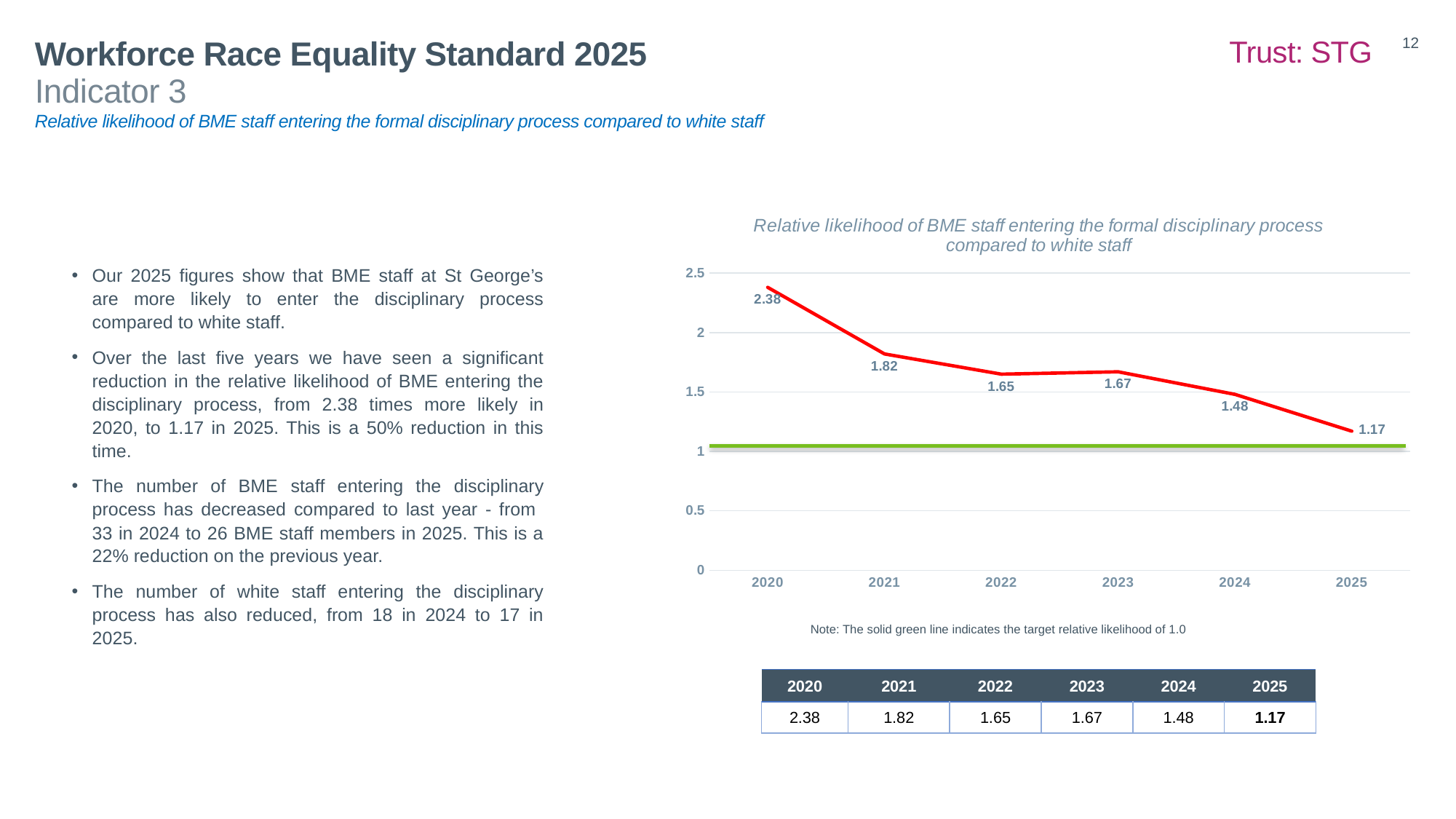
What is the relative likelihood value for 2023? 1.67 Which year has the larger value, 2022 or 2023? 2023 Which year has the lowest relative likelihood value? 2025 What is the relative likelihood value for 2020? 2.38 How many years are plotted on the x axis? 6 Which year has the highest relative likelihood value? 2020 What is the relative likelihood value for 2025? 1.17 Do the values generally rise or fall from 2020 to 2025? fall What kind of chart is shown? line chart What is the difference between the 2020 value and the 2025 value? 1.21 What is the difference between the 2021 value and the 2022 value? 0.17 Is the value for 2024 greater or less than 1.5? less